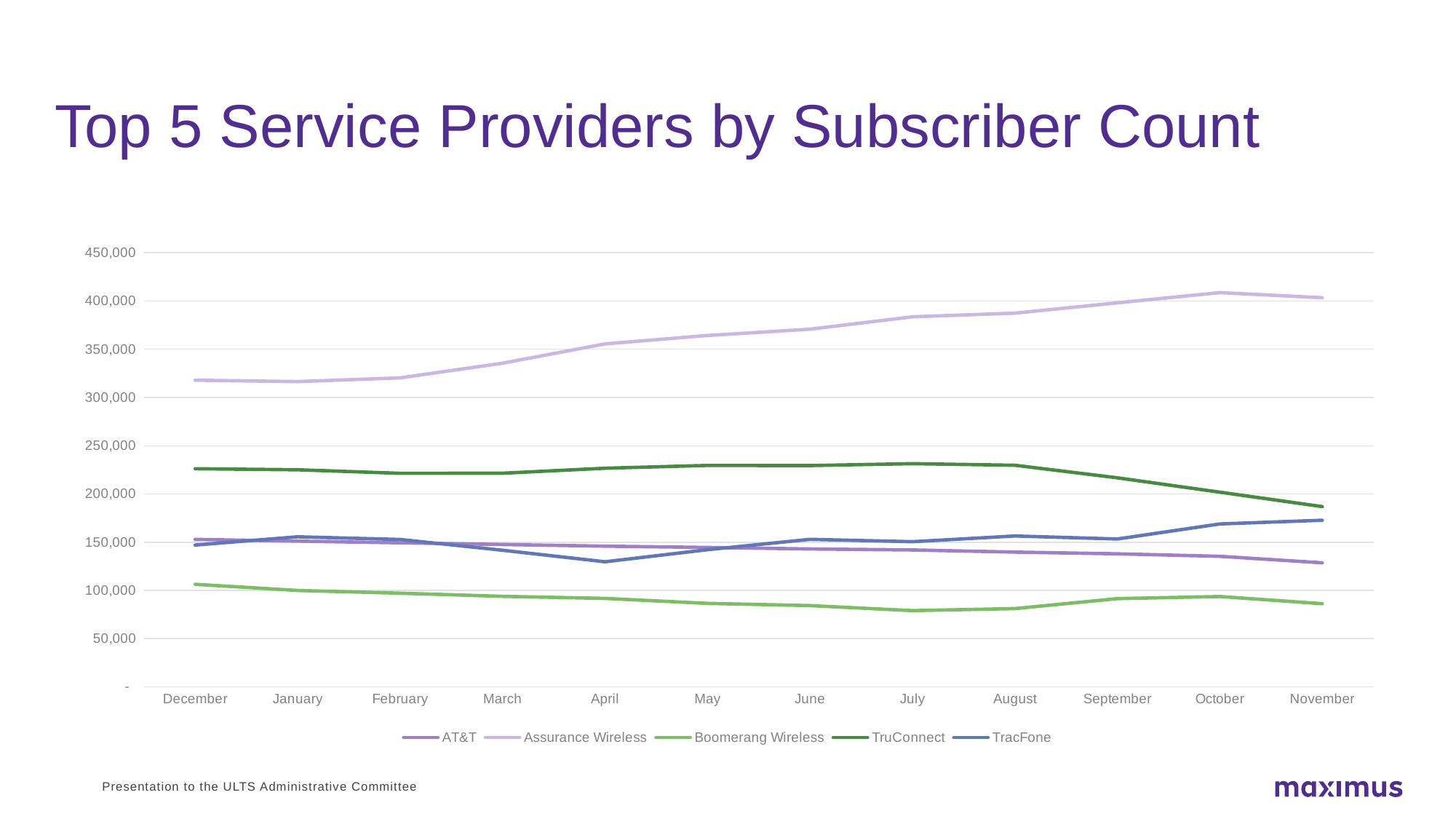
Is the value for TracFone in April greater or less than 150,000? less Is the value for TruConnect in November greater or less than 200,000? less What kind of chart is shown on the slide? line chart Does the Assurance Wireless line rise or fall from December to October? rise In which month does Assurance Wireless reach its highest subscriber count? October How many series does the legend list? 5 Is the value for Boomerang Wireless in July greater or less than 100,000? less How many months are shown along the x axis? 12 Which service provider has the lowest subscriber count across the whole period? Boomerang Wireless In November, which is larger: TracFone or AT&T? TracFone Which service provider has the highest subscriber count across the whole period? Assurance Wireless